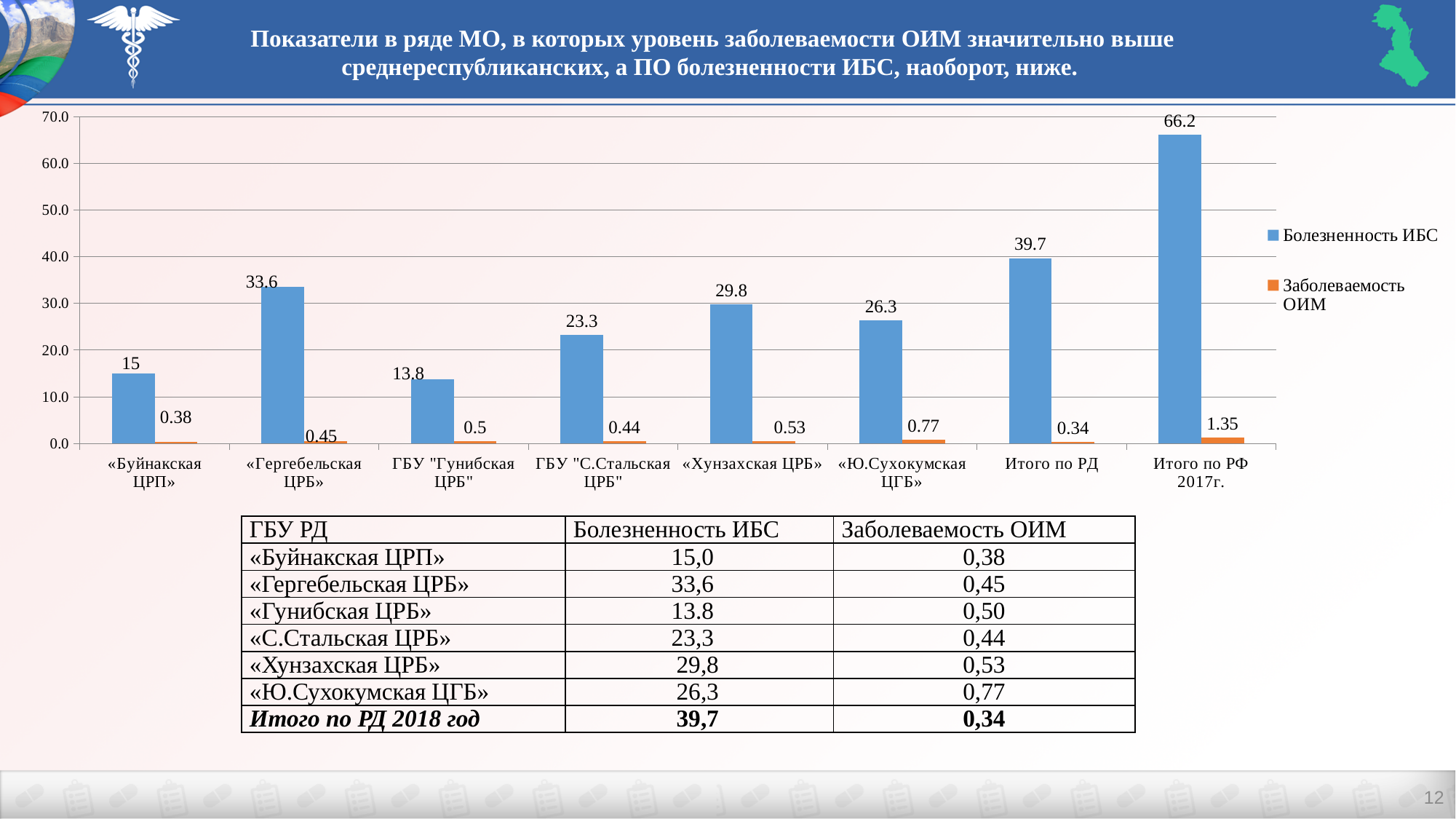
Which category has the lowest value of Заболеваемость ОИМ? Итого по РД What is the value of Болезненность ИБС for Итого по РФ 2017г.? 66.2 What is the value of Болезненность ИБС for «Гергебельская ЦРБ»? 33.6 How many categories are shown on the x axis of the chart? 8 How many series does the chart legend list? 2 Which has a larger Болезненность ИБС value: «Хунзахская ЦРБ» or «Ю.Сухокумская ЦГБ»? «Хунзахская ЦРБ» Which series is shown in orange in the chart? Заболеваемость ОИМ What is the difference in Болезненность ИБС between Итого по РФ 2017г. and Итого по РД? 26.5 Which category has the highest value of Болезненность ИБС? Итого по РФ 2017г. What is the value of Заболеваемость ОИМ for «Ю.Сухокумская ЦГБ»? 0.77 Which category has the lowest value of Болезненность ИБС? ГБУ "Гунибская ЦРБ" What type of chart is shown on the slide? bar chart